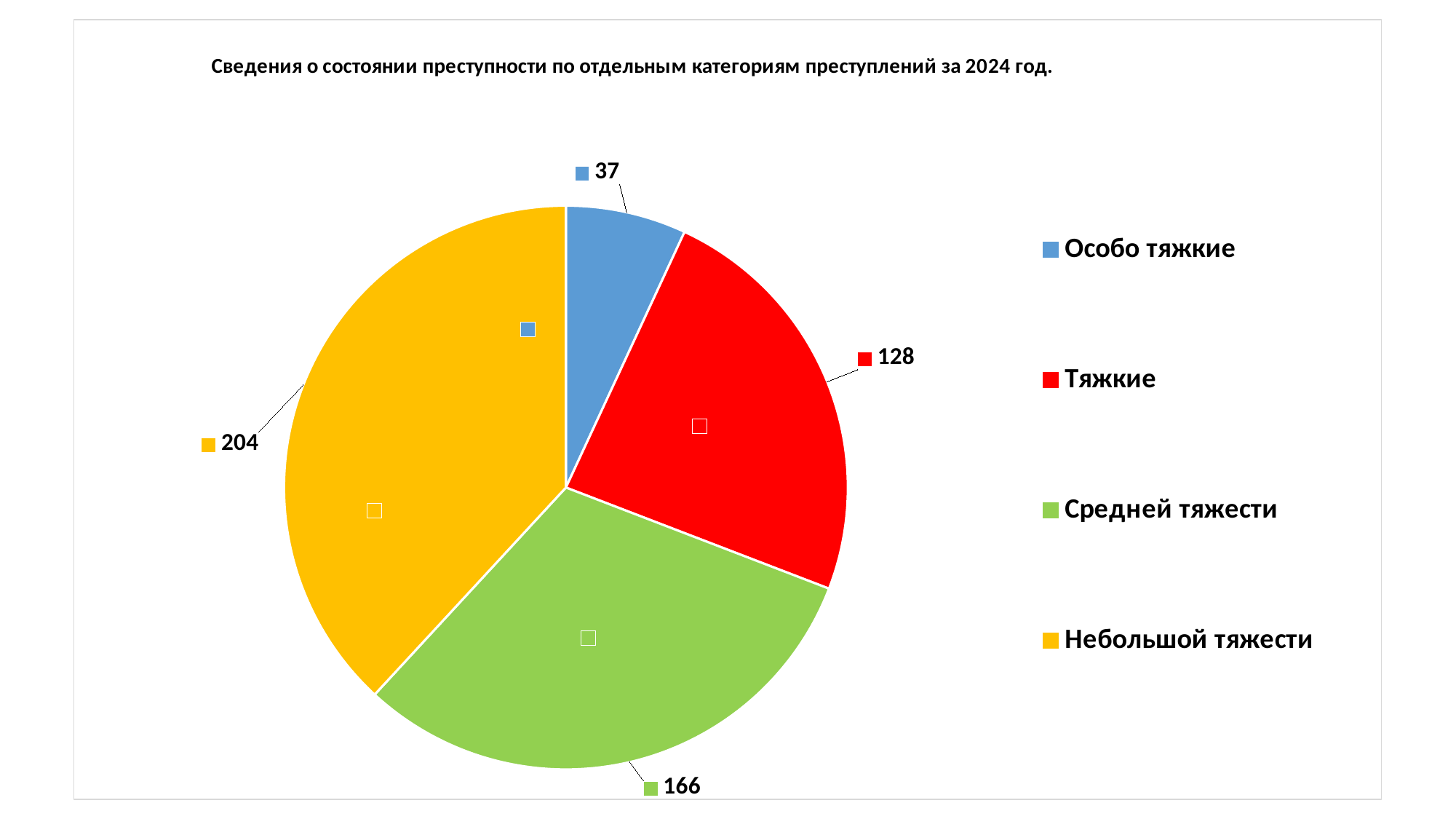
What is the difference between the values for Небольшой тяжести and Средней тяжести? 38 What is the value for Небольшой тяжести? 204 What is the value for Особо тяжкие? 37 Which category has the largest slice of the pie? Небольшой тяжести What is the difference between the values for Тяжкие and Особо тяжкие? 91 What kind of chart is shown on the slide? Pie chart Which category has the smallest slice of the pie? Особо тяжкие What is the value for Тяжкие? 128 What is the value for Средней тяжести? 166 What is the title of the chart? Сведения о состоянии преступности по отдельным категориям преступлений за 2024 год. How many categories are shown in the pie chart? 4 Which is larger, the value for Тяжкие or the value for Средней тяжести? Средней тяжести